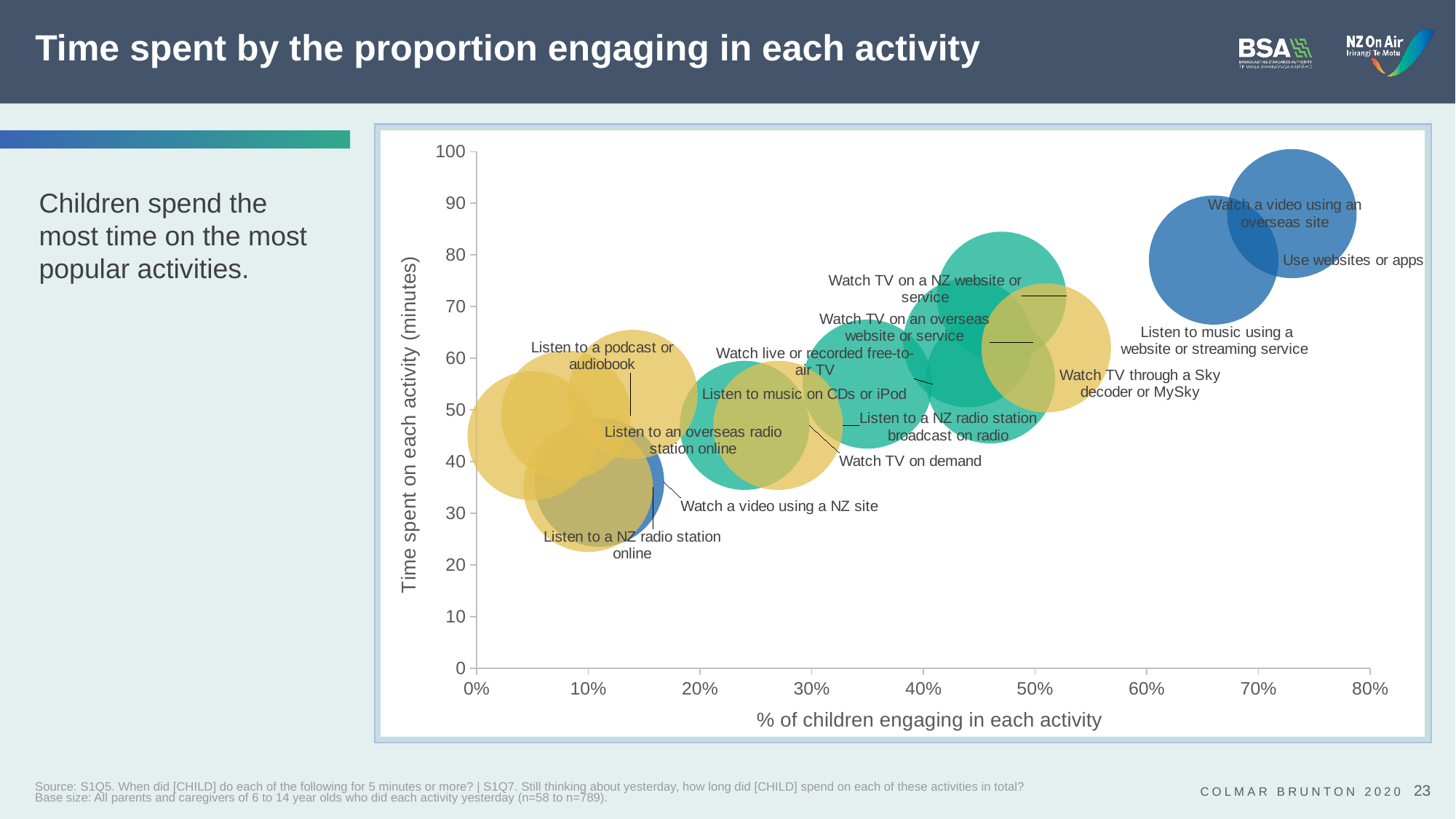
Is the proportion of children engaging in 'Listen to a podcast or audiobook' greater or less than 20%? less What is the title of the vertical axis? Time spent on each activity (minutes) Is the time spent on 'Watch a video using an overseas site' greater or less than 80 minutes? greater Which has a higher proportion of children engaging: 'Use websites or apps' or 'Listen to a podcast or audiobook'? Use websites or apps Is the proportion of children engaging in 'Use websites or apps' greater or less than 60%? greater Which activity has the highest time spent on the chart? Watch a video using an overseas site Which activity has more time spent on it: 'Watch a video using an overseas site' or 'Watch a video using a NZ site'? Watch a video using an overseas site Which activity has the lowest proportion of children engaging in it? Listen to an overseas radio station online How many activities are plotted on the chart? 14 Which activity has the highest proportion of children engaging in it? Watch a video using an overseas site What kind of chart is shown on the slide? Bubble chart